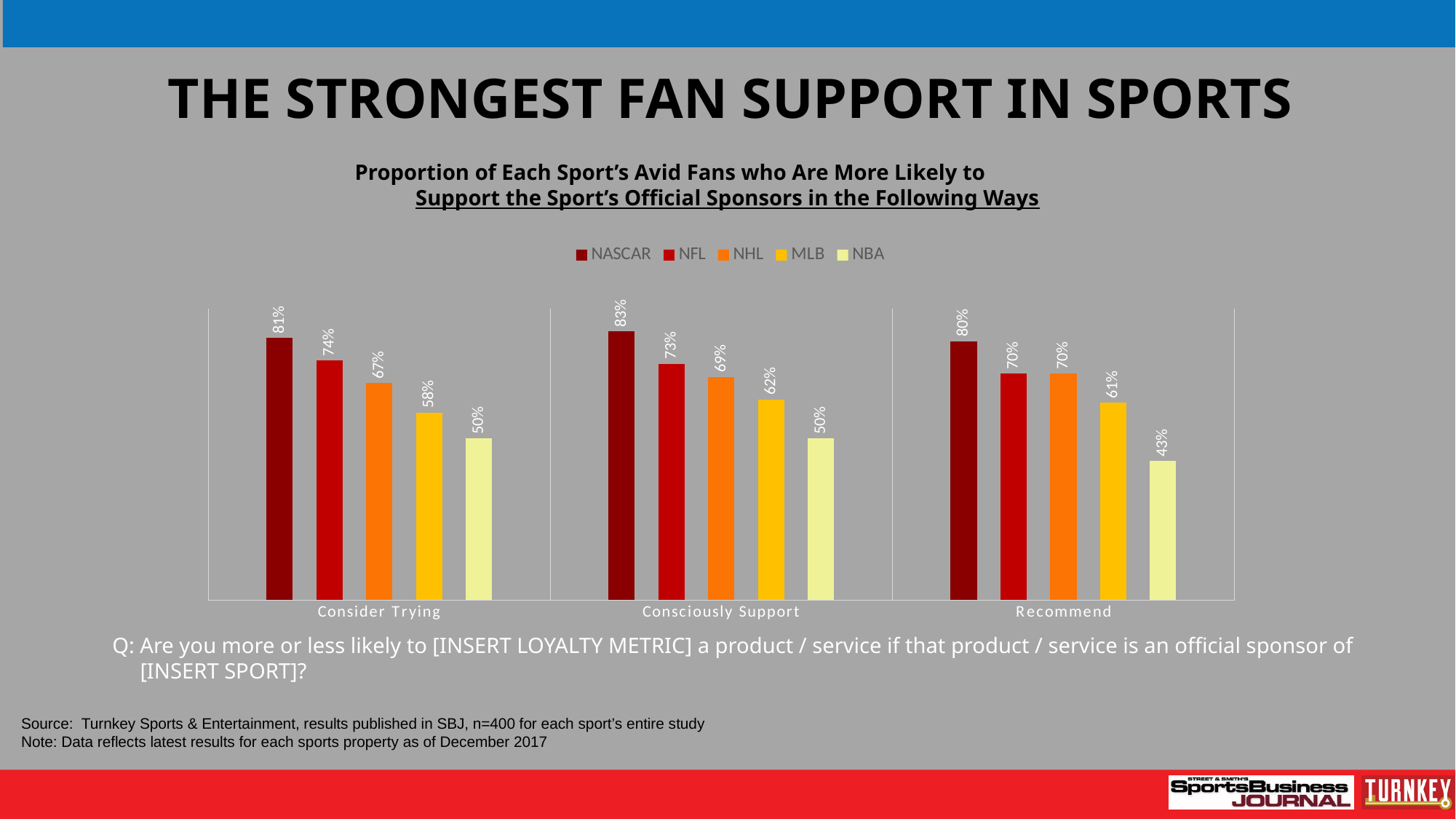
What kind of chart is shown on the slide? Bar chart How many categories are shown on the x axis? 3 Which sport has the highest value in the Consciously Support category? NASCAR What is the difference between the NASCAR and NBA values in the Consider Trying category? 31% Which is larger: the MLB value for Consider Trying or the MLB value for Recommend? Recommend What is the value for NBA in the Recommend category? 43% What is the difference between the NFL and MLB values in the Consciously Support category? 11% Which sport has the lowest value in the Recommend category? NBA What is the value for NASCAR in the Consider Trying category? 81% What is the value for NHL in the Consciously Support category? 69% Which series is shown in the lightest (pale yellow) colour? NBA How many series does the legend list? 5